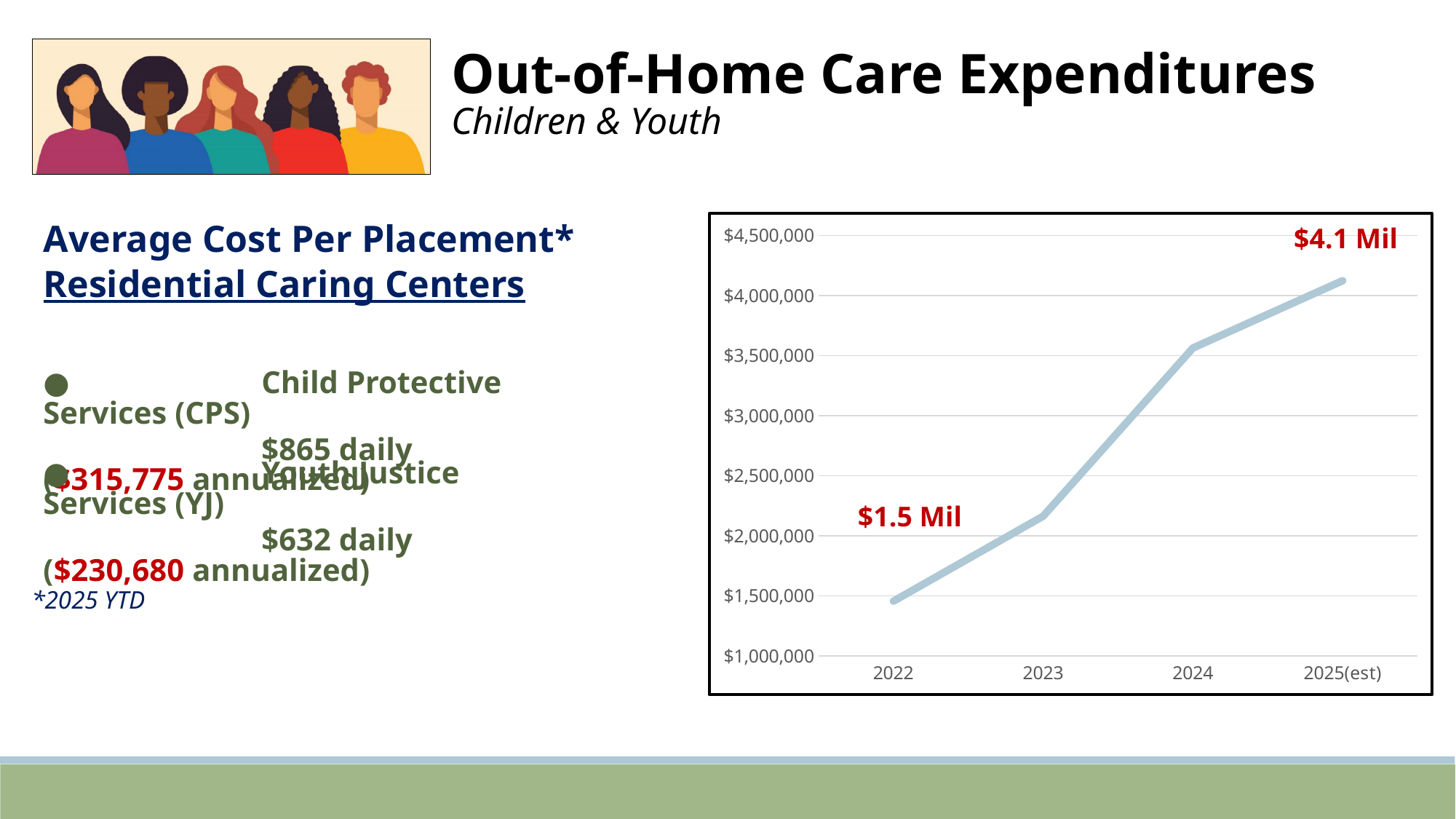
What value is labelled on the chart for 2022? $1.5 Mil Do the expenditures rise or fall from 2022 to 2025(est)? rise Is the value for 2023 greater or less than $2,000,000? greater Which year has the highest expenditure on the chart? 2025(est) How many years are plotted along the x axis of the chart? 4 Which year has the lowest expenditure on the chart? 2022 Is the value for 2024 greater or less than $3,000,000? greater Which is larger, the value for 2024 or the value for 2023? 2024 Is the value for 2022 greater or less than $2,000,000? less What value is labelled on the chart for 2025(est)? $4.1 Mil What is the difference between the labelled values for 2025(est) and 2022? $2.6 Mil What kind of chart is shown on the slide? line chart